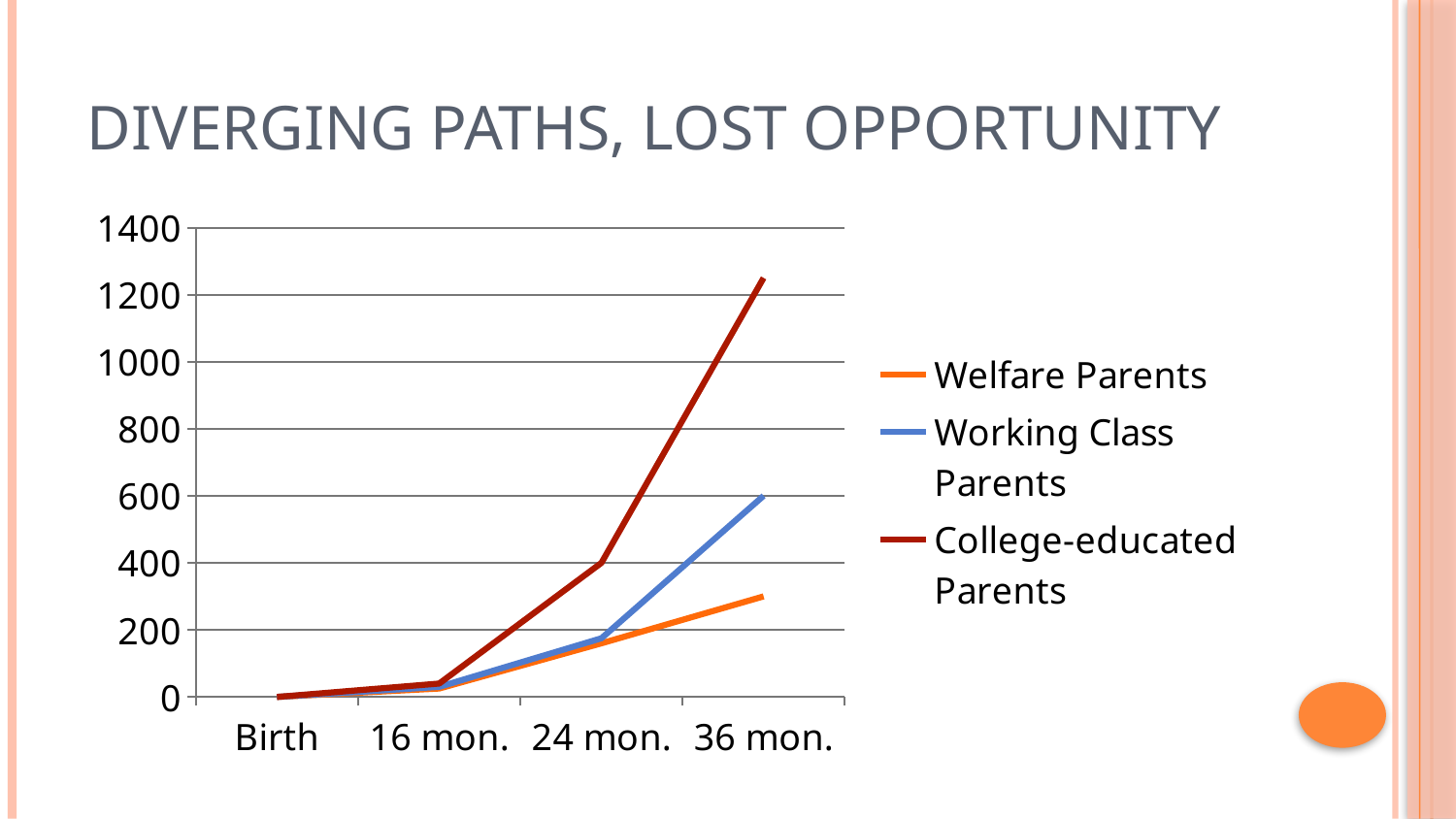
What is the title of the slide containing the chart? DIVERGING PATHS, LOST OPPORTUNITY Which series has the lowest value at 36 mon.? Welfare Parents What kind of chart is shown on the slide? line chart Is the value for Working Class Parents at 36 mon. greater or less than 800? less At 24 mon., which is larger: College-educated Parents or Welfare Parents? College-educated Parents Is the value for Welfare Parents at 36 mon. greater or less than 400? less At 36 mon., which is larger: Working Class Parents or Welfare Parents? Working Class Parents How many series does the legend list? 3 Is the value for College-educated Parents at 36 mon. greater or less than 1000? greater Which series has the highest value at 36 mon.? College-educated Parents Do the values for College-educated Parents rise or fall from Birth to 36 mon.? rise How many points are there along the x axis? 4